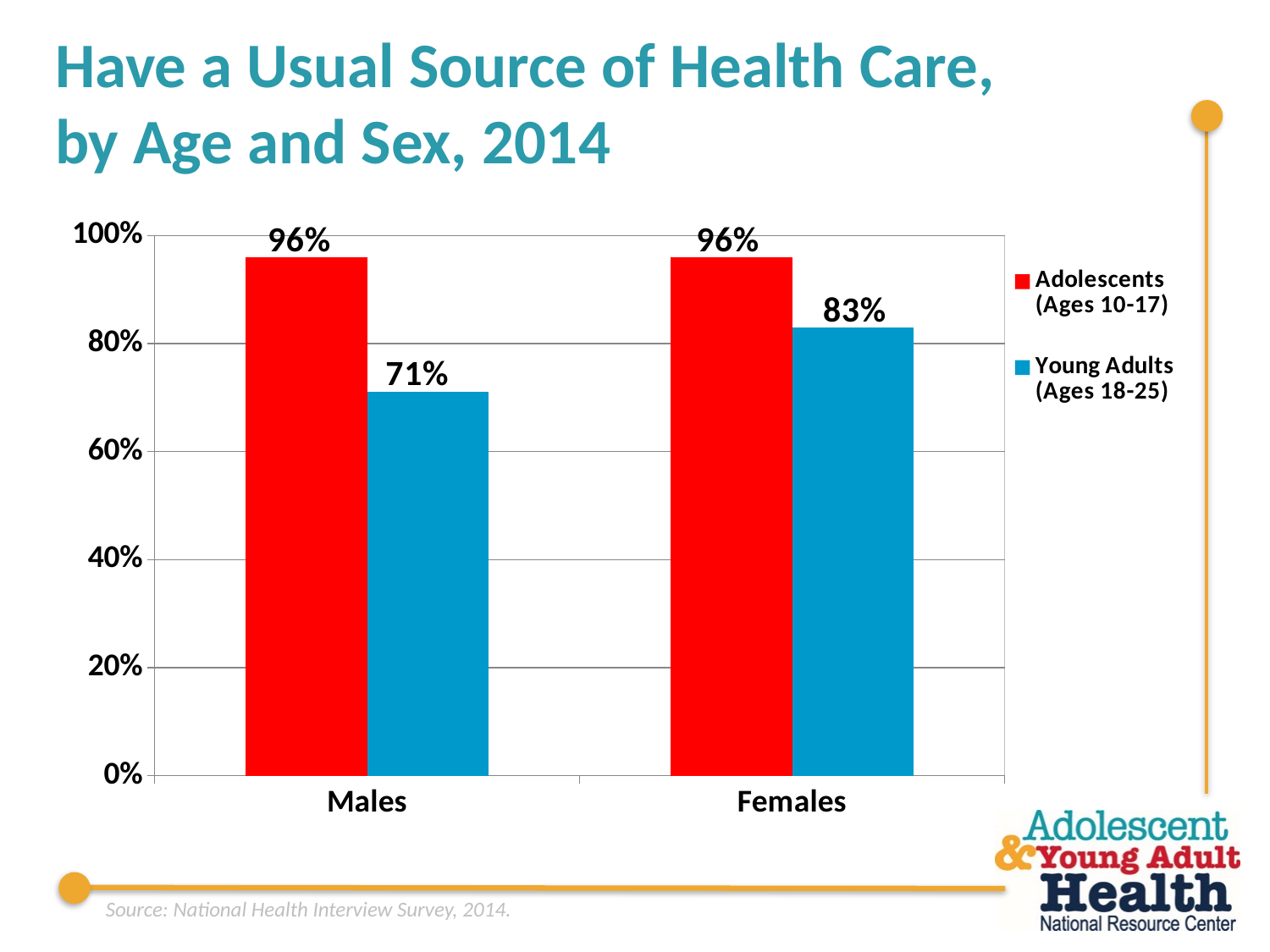
What percentage of male adolescents (ages 10-17) have a usual source of health care? 96% How many categories are shown on the x axis? 2 What percentage of female young adults (ages 18-25) have a usual source of health care? 83% What is the difference between the percentages for male adolescents and male young adults? 25 percentage points What percentage of male young adults (ages 18-25) have a usual source of health care? 71% What is the difference between the percentages for female young adults and male young adults? 12 percentage points How many series does the legend list? 2 Which is larger: the percentage for female young adults or male young adults? Female young adults What kind of chart is shown on the slide? Bar chart Is the value for male young adults greater or less than 80%? less What percentage of female adolescents (ages 10-17) have a usual source of health care? 96% Which group has the lowest percentage with a usual source of health care? Male young adults (ages 18-25)